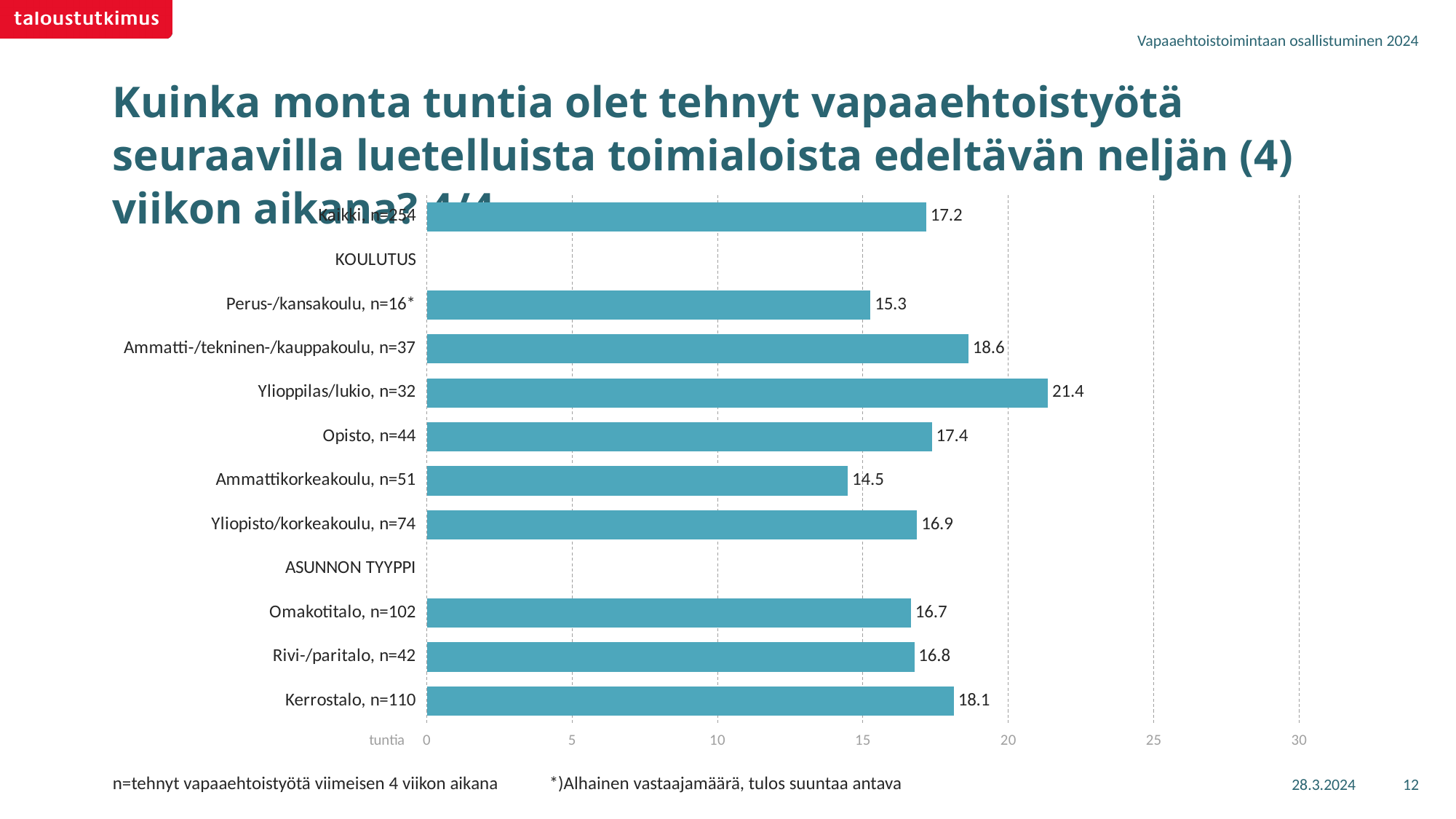
How many bars are plotted in the chart? 10 Which category has the highest value? Ylioppilas/lukio, n=32 What is the value for Kerrostalo, n=110? 18.1 What is the value for Ammattikorkeakoulu, n=51? 14.5 What is the difference between the values for Kerrostalo, n=110 and Omakotitalo, n=102? 1.4 Is the value for Ylioppilas/lukio, n=32 greater or less than 20? greater What is the difference between the values for Ylioppilas/lukio, n=32 and Ammattikorkeakoulu, n=51? 6.9 What kind of chart is shown on the slide? bar chart Which is larger, the value for Ammatti-/tekninen-/kauppakoulu, n=37 or the value for Opisto, n=44? Ammatti-/tekninen-/kauppakoulu, n=37 What is the value for Perus-/kansakoulu, n=16*? 15.3 What is the value for Ylioppilas/lukio, n=32? 21.4 Which category has the lowest value? Ammattikorkeakoulu, n=51